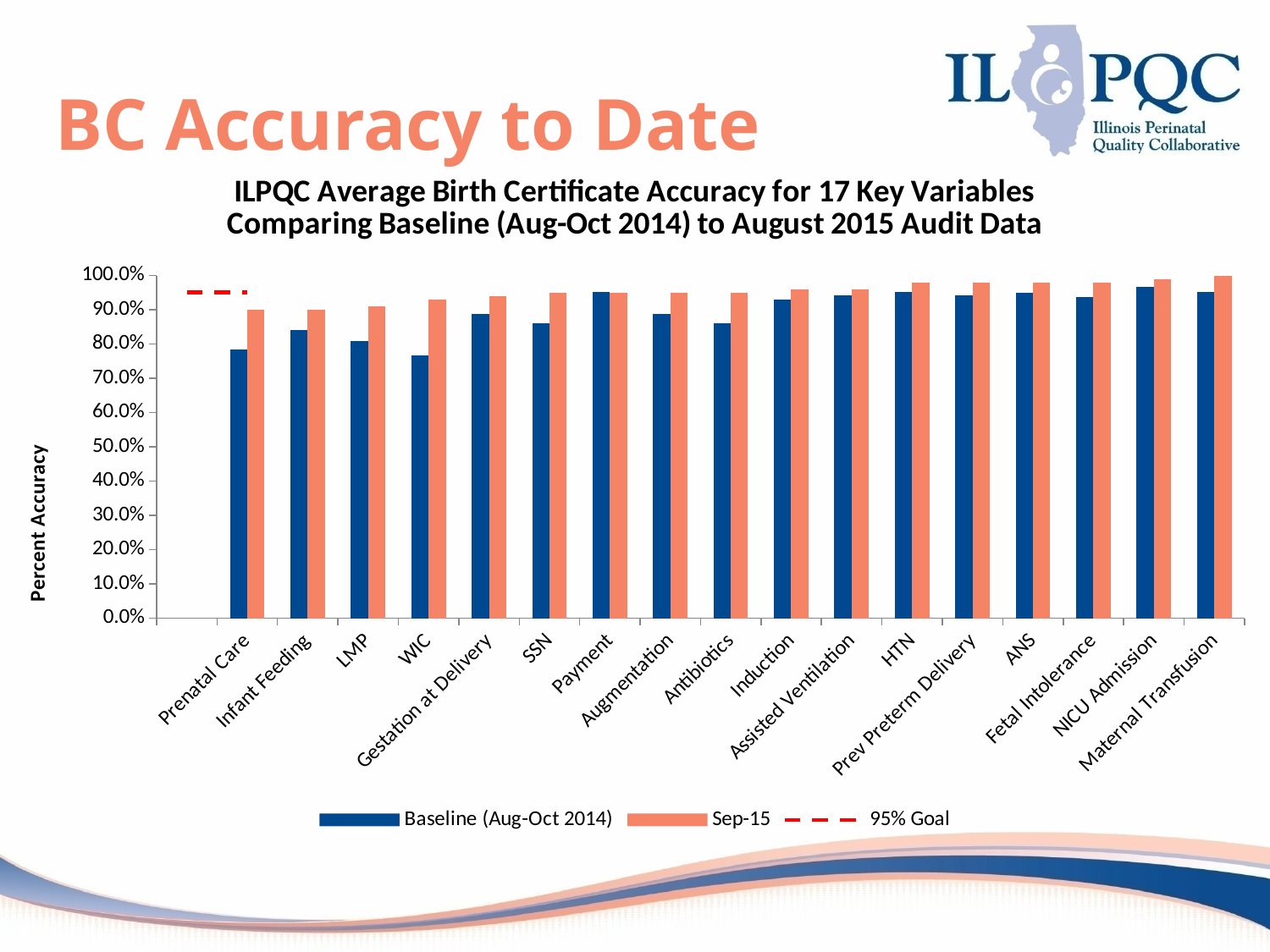
What does the red dashed line in the chart represent? 95% Goal Is the Baseline (Aug-Oct 2014) value for Payment greater or less than 90.0%? greater Is the Sep-15 value for Induction greater or less than 90.0%? greater Is the Baseline (Aug-Oct 2014) value for Antibiotics greater or less than 90.0%? less Do the Sep-15 values generally rise or fall from left to right across the x axis? rise For WIC, which is larger: the Baseline (Aug-Oct 2014) value or the Sep-15 value? Sep-15 What kind of chart is shown on the slide? Bar chart How many variables (categories) are shown along the x axis? 17 For Prenatal Care, which is larger: the Baseline (Aug-Oct 2014) value or the Sep-15 value? Sep-15 How many entries does the legend list? 3